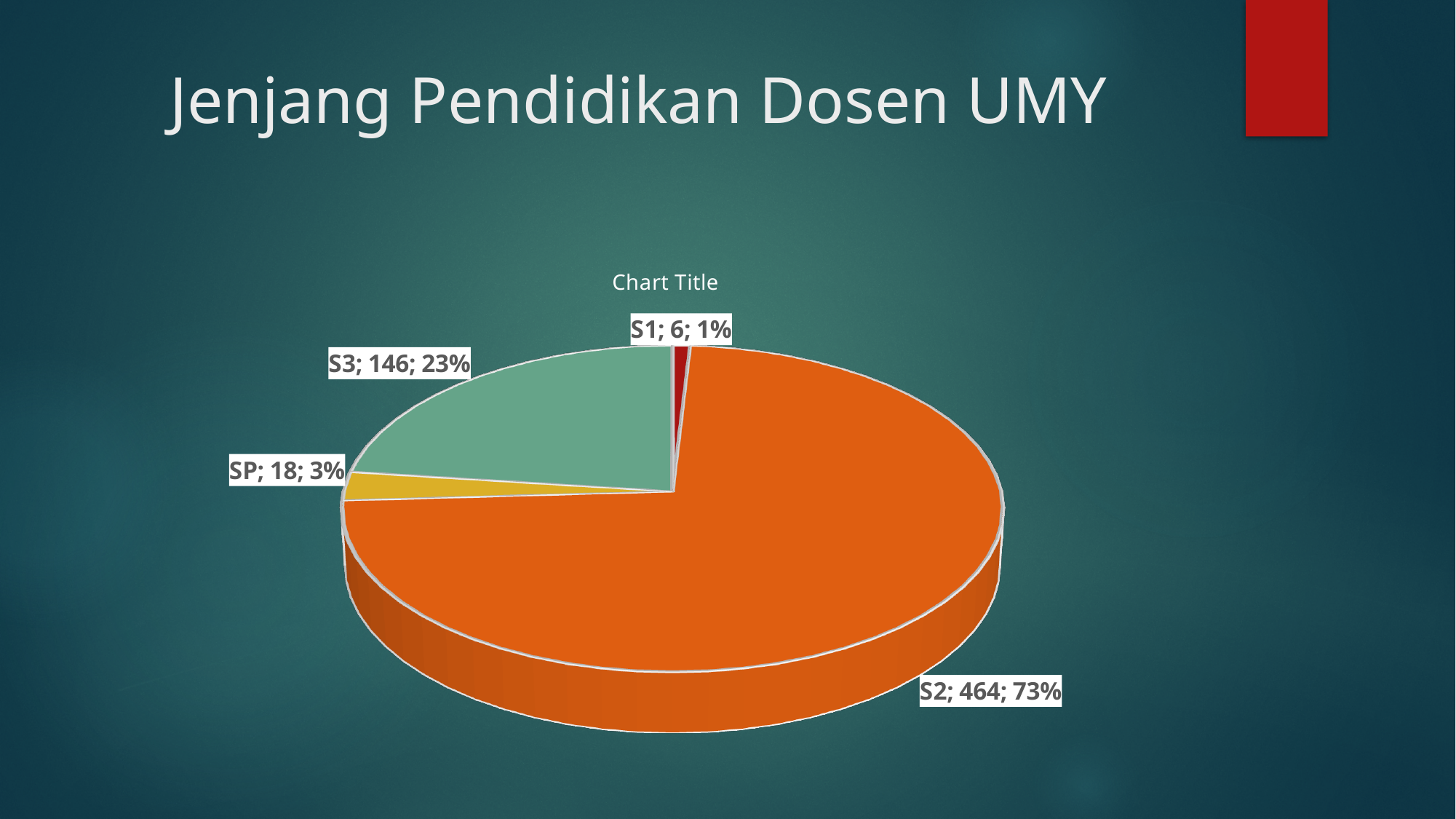
What is the title of the slide? Jenjang Pendidikan Dosen UMY What is the value for SP? 18 What is the difference between the values for S2 and S3? 318 What is the value for S3? 146 Which is larger, the value for SP or the value for S1? SP What kind of chart is shown on the slide? Pie chart What share of the pie does S3 represent? 23% Which category has the largest slice of the pie? S2 How many categories are shown in the pie chart? 4 What is the value for S2? 464 What is the value for S1? 6 Which category has the smallest slice of the pie? S1